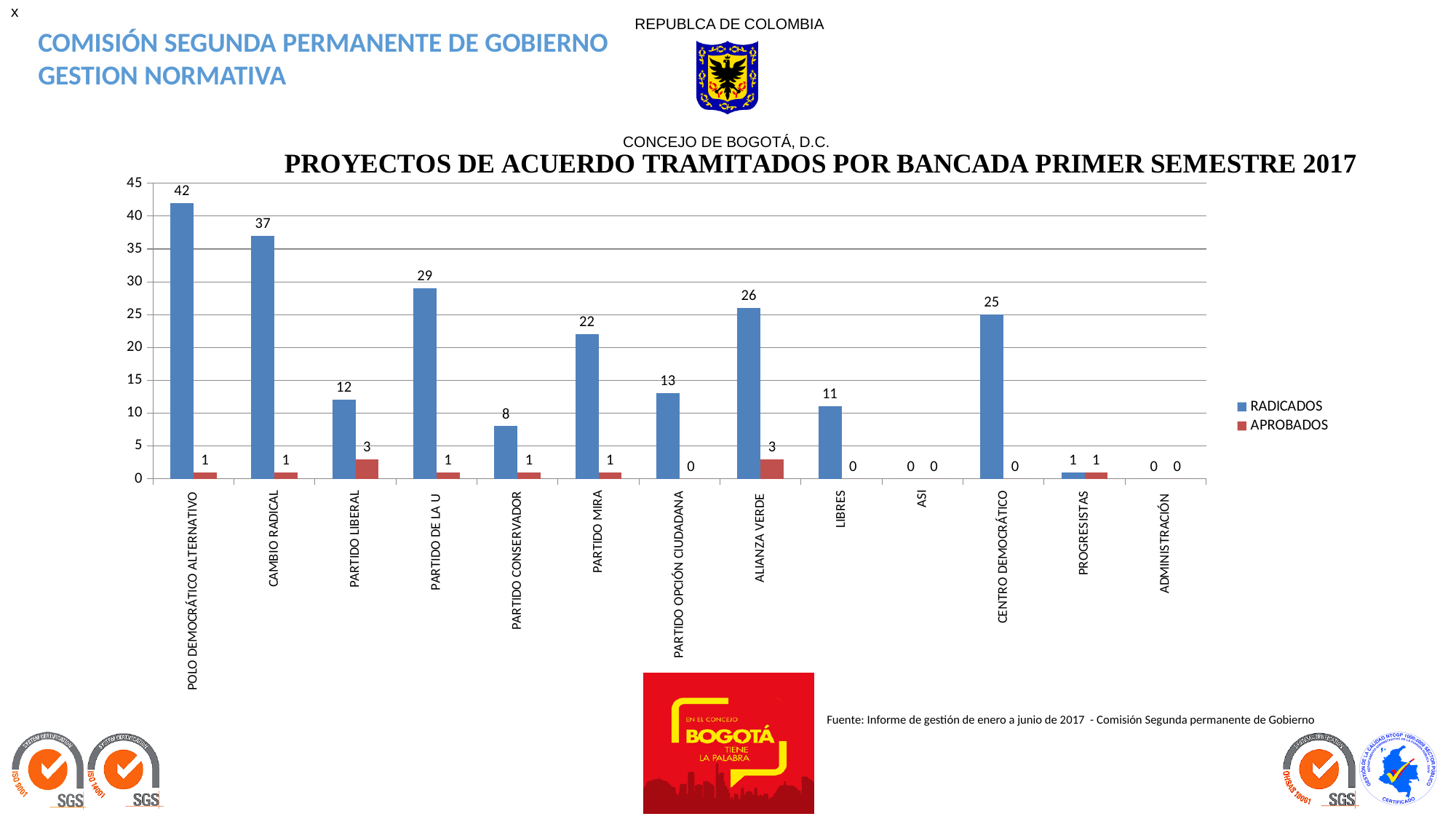
What is the APROBADOS value for PARTIDO LIBERAL? 3 What kind of chart is shown on the slide? bar chart Which category has the highest RADICADOS value? POLO DEMOCRÁTICO ALTERNATIVO What is the RADICADOS value for CENTRO DEMOCRÁTICO? 25 How many categories are shown on the x axis? 13 How many series does the legend list? 2 Which has a larger RADICADOS value, ALIANZA VERDE or PARTIDO MIRA? ALIANZA VERDE What is the APROBADOS value for PARTIDO OPCIÓN CIUDADANA? 0 What is the difference between the RADICADOS values for POLO DEMOCRÁTICO ALTERNATIVO and PARTIDO DE LA U? 13 Is the RADICADOS value for PARTIDO CONSERVADOR greater or less than 10? less What is the RADICADOS value for CAMBIO RADICAL? 37 What is the title of the chart? PROYECTOS DE ACUERDO TRAMITADOS POR BANCADA PRIMER SEMESTRE 2017